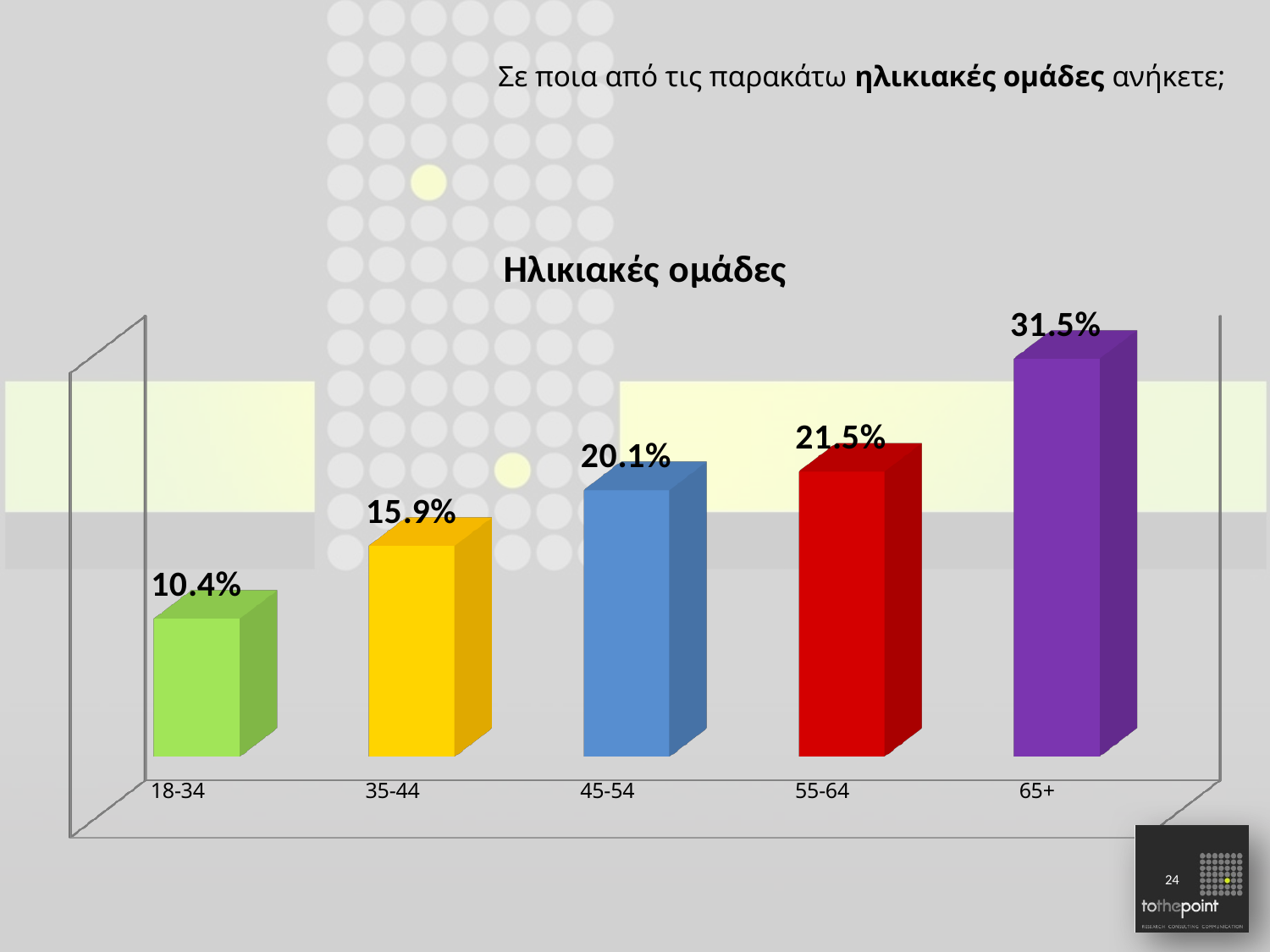
What is the difference between the values for 35-44 and 18-34? 5.5% Do the values rise or fall from the 18-34 group to the 65+ group? Rise What is the difference between the values for 65+ and 55-64? 10.0% Which is larger, the value for 45-54 or the value for 55-64? 55-64 What is the value for the 18-34 age group? 10.4% What is the value for the 65+ age group? 31.5% Which age group has the lowest value? 18-34 What is the title of the chart? Ηλικιακές ομάδες How many age groups are shown in the chart? 5 What is the value for the 45-54 age group? 20.1% Which age group has the highest value? 65+ What kind of chart is shown on the slide? Bar chart